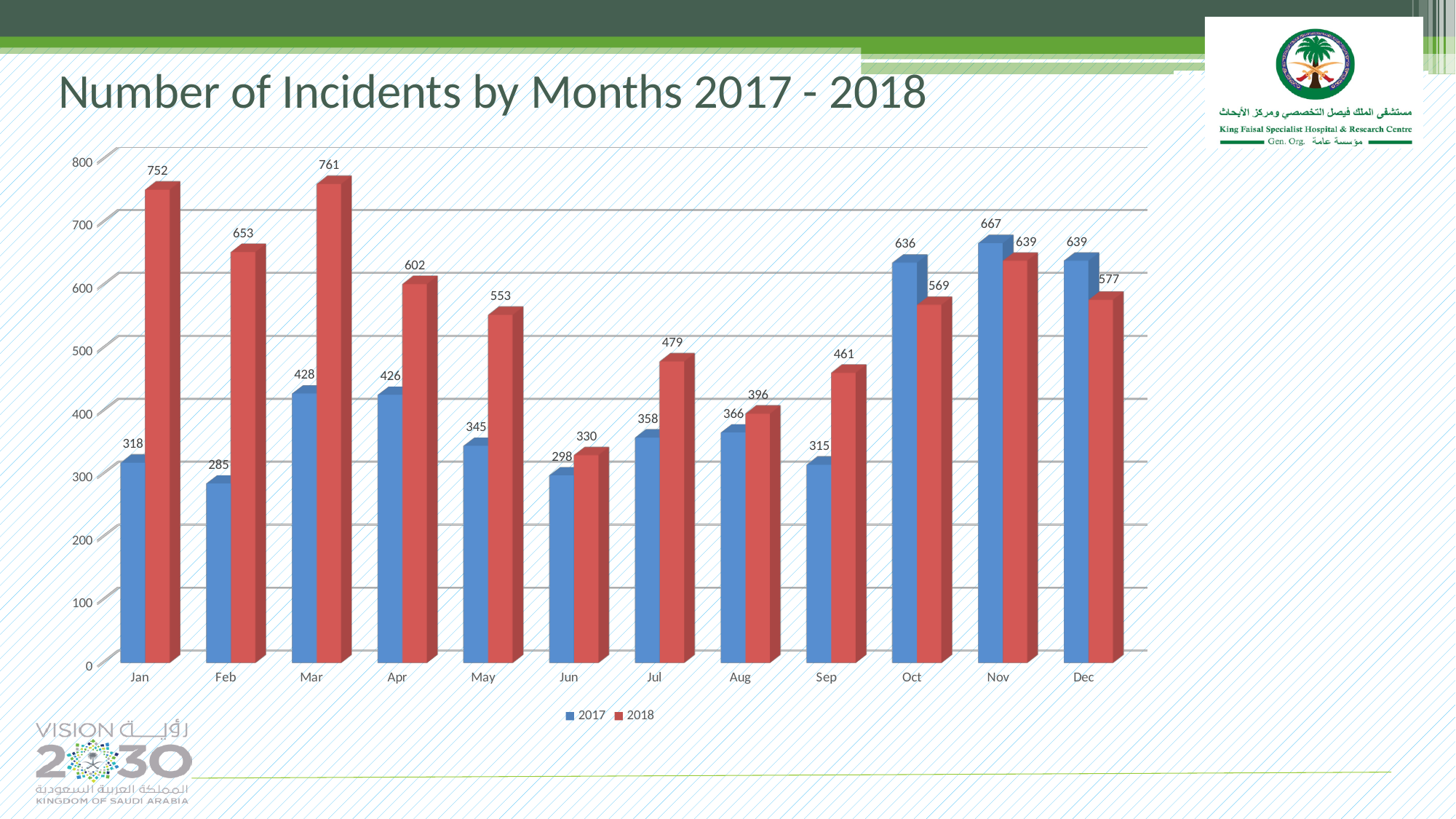
Which month has the lowest number of incidents in the 2017 series? Feb What is the number of incidents for 2017 in October? 636 How many series does the legend list? 2 What kind of chart is shown on the slide? Bar chart What is the difference between the 2017 and 2018 values in October? 67 Do the 2018 values rise or fall from March to June? Fall Which month has the highest number of incidents in the 2018 series? Mar What is the number of incidents for 2018 in January? 752 Which month has the lowest number of incidents in the 2018 series? Jun How many months are shown on the x axis? 12 In November, which series has the larger value, 2017 or 2018? 2017 What is the difference between the 2018 and 2017 values in January? 434